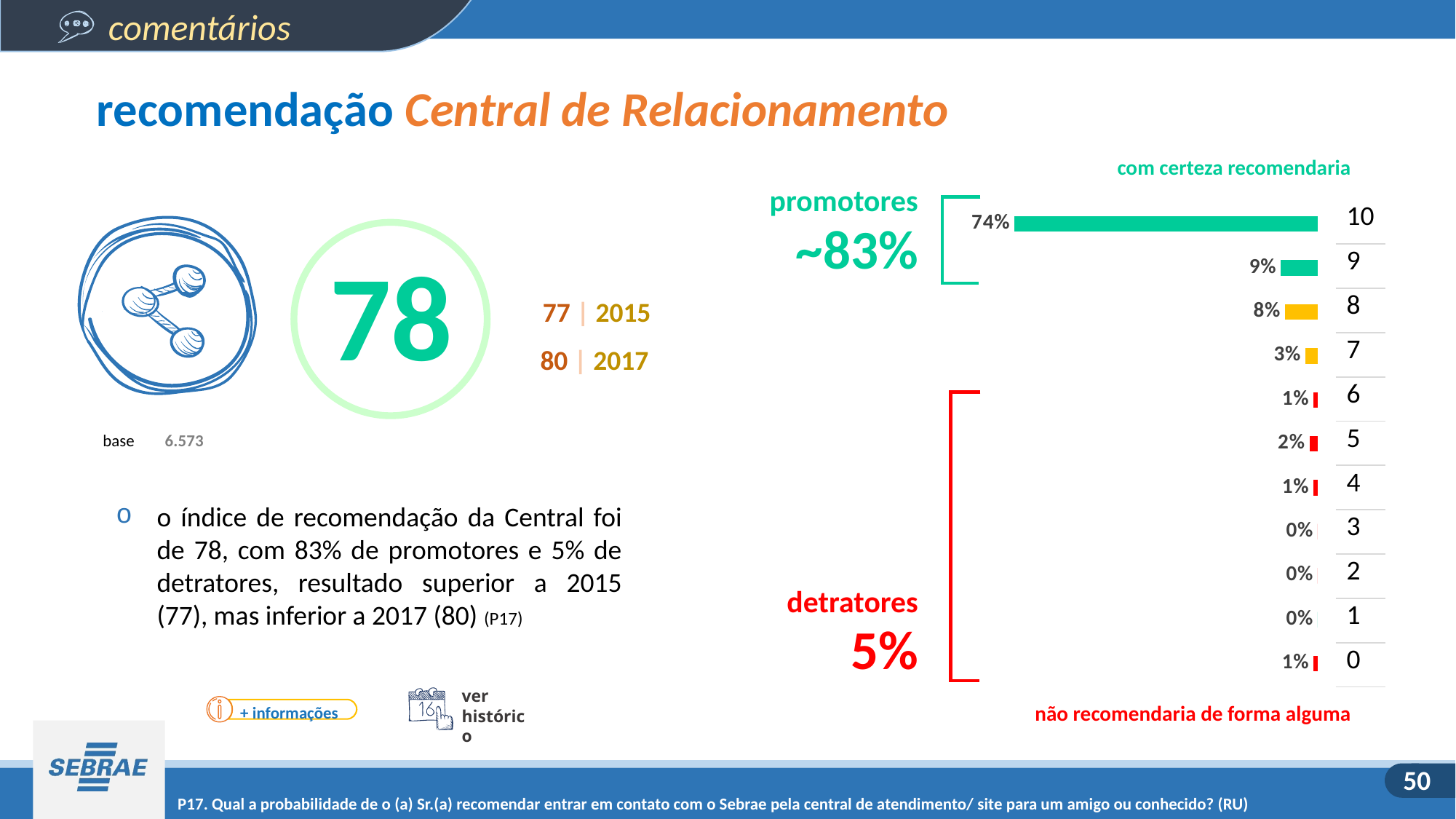
What percentage of respondents gave a score of 9? 9% What is the difference between the percentage for score 10 and the percentage for score 9? 65% What kind of chart is shown on the right side of the slide? bar chart What percentage of respondents gave a score of 7? 3% What percentage of respondents gave a score of 10? 74% What percentage is shown for the detratores group? 5% How many score categories are shown in the bar chart? 11 What label is shown at the top of the chart above the score of 10? com certeza recomendaria What is the combined percentage for scores 10 and 9 (the promotores group)? 83% What percentage of respondents gave a score of 5? 2% Which has a larger percentage: score 8 or score 7? score 8 Which score has the highest percentage of respondents? 10